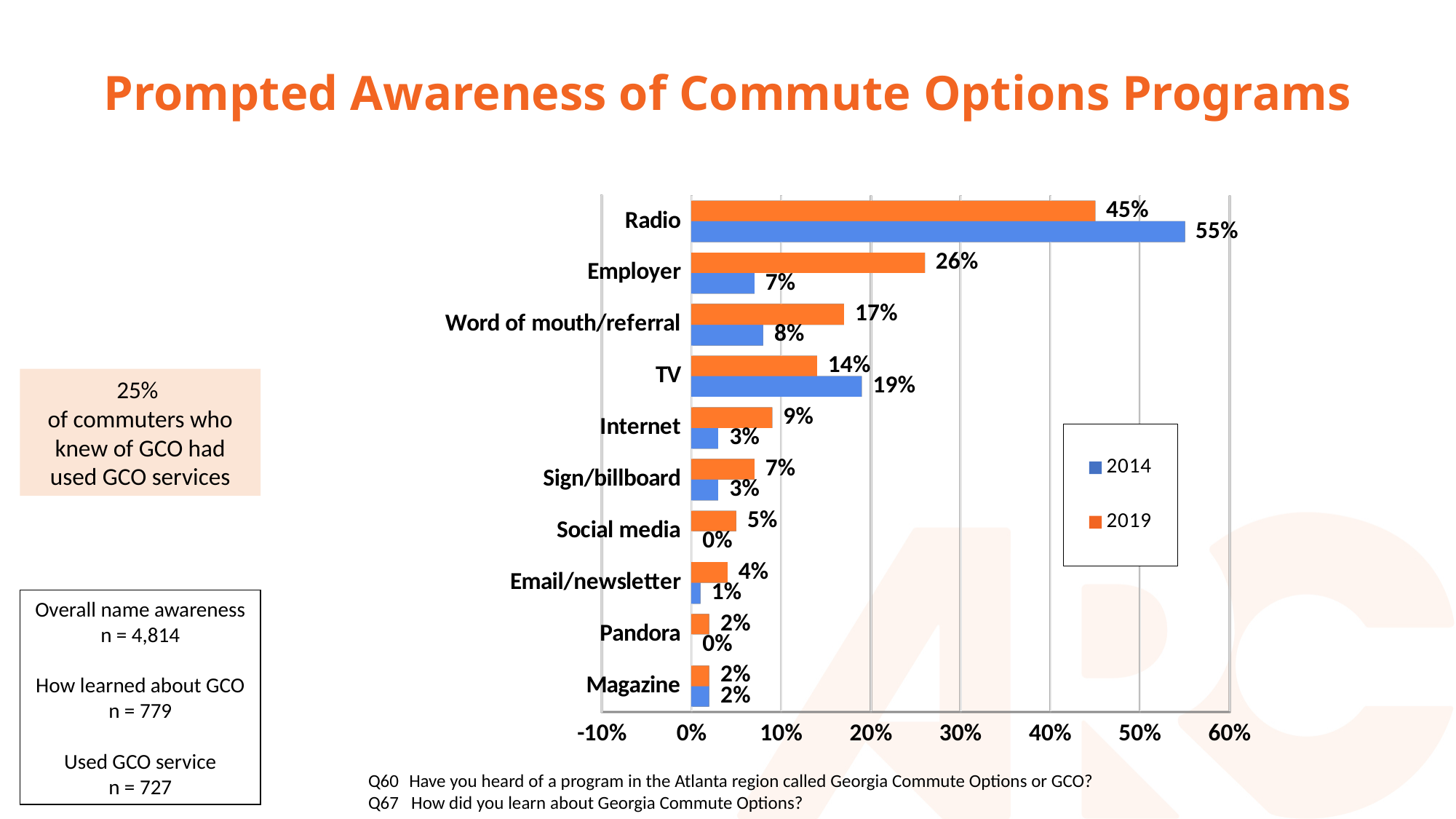
Which category has the lowest 2019 value? Pandora and Magazine (both 2%) What kind of chart is shown on the slide? bar chart What is the difference between the 2019 and 2014 values for Employer? 19% Is the 2014 value for Radio greater or less than 50%? greater How many series does the legend list? 2 What is the 2019 value for Word of mouth/referral? 17% What is the 2014 value for Employer? 7% What is the difference between the 2014 and 2019 values for Radio? 10% Which is larger for TV, the 2014 value or the 2019 value? 2014 Which category has the highest 2014 value? Radio How many categories are shown on the chart? 10 What is the 2019 value for Radio? 45%